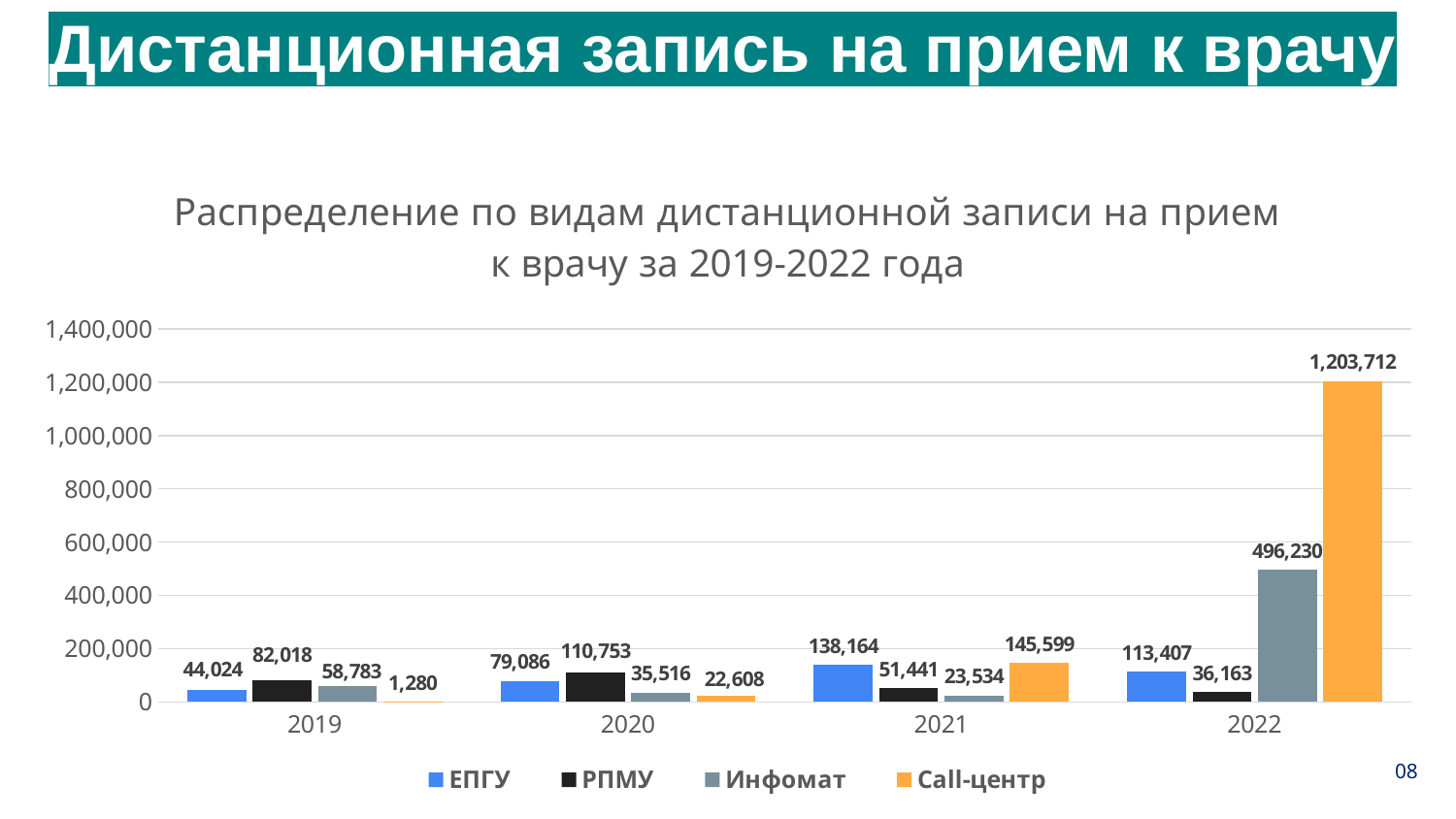
Which series has the lowest value in 2022? РПМУ What is the value for Call-центр in 2019? 1,280 How many series does the legend list? 4 What is the difference between the Инфомат values in 2022 and 2021? 472,696 Which is larger in 2021: ЕПГУ or Call-центр? Call-центр What is the value for Инфомат in 2020? 35,516 What kind of chart is shown on the slide? Bar chart Which series has the highest value in 2020? РПМУ What is the value for ЕПГУ in 2021? 138,164 Is the value for Инфомат in 2022 greater or less than 400,000? greater How many years are shown on the x axis? 4 What is the value for Call-центр in 2022? 1,203,712